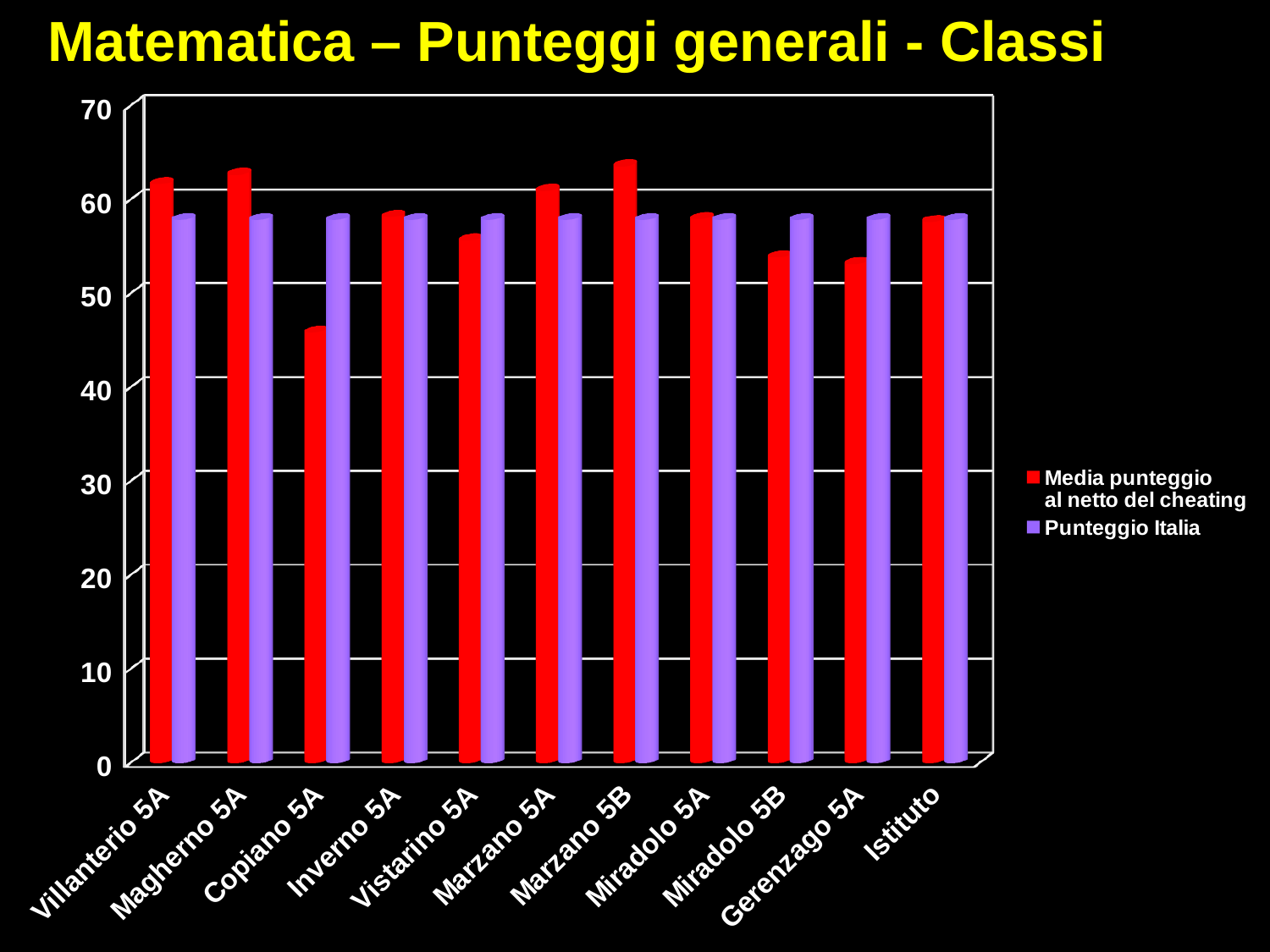
Is the 'Media punteggio al netto del cheating' value for Miradolo 5B greater or less than 60? less What kind of chart is shown on the slide? bar chart Is the 'Media punteggio al netto del cheating' value for Copiano 5A greater or less than 50? less What is the title of the chart on the slide? Matematica – Punteggi generali - Classi How many categories are shown on the x axis of the chart? 11 For Marzano 5B, which is larger: 'Media punteggio al netto del cheating' or 'Punteggio Italia'? Media punteggio al netto del cheating Is the 'Media punteggio al netto del cheating' value for Villanterio 5A greater or less than 60? greater For Copiano 5A, which is larger: 'Media punteggio al netto del cheating' or 'Punteggio Italia'? Punteggio Italia Which category has the lowest value for 'Media punteggio al netto del cheating'? Copiano 5A How many series does the legend list? 2